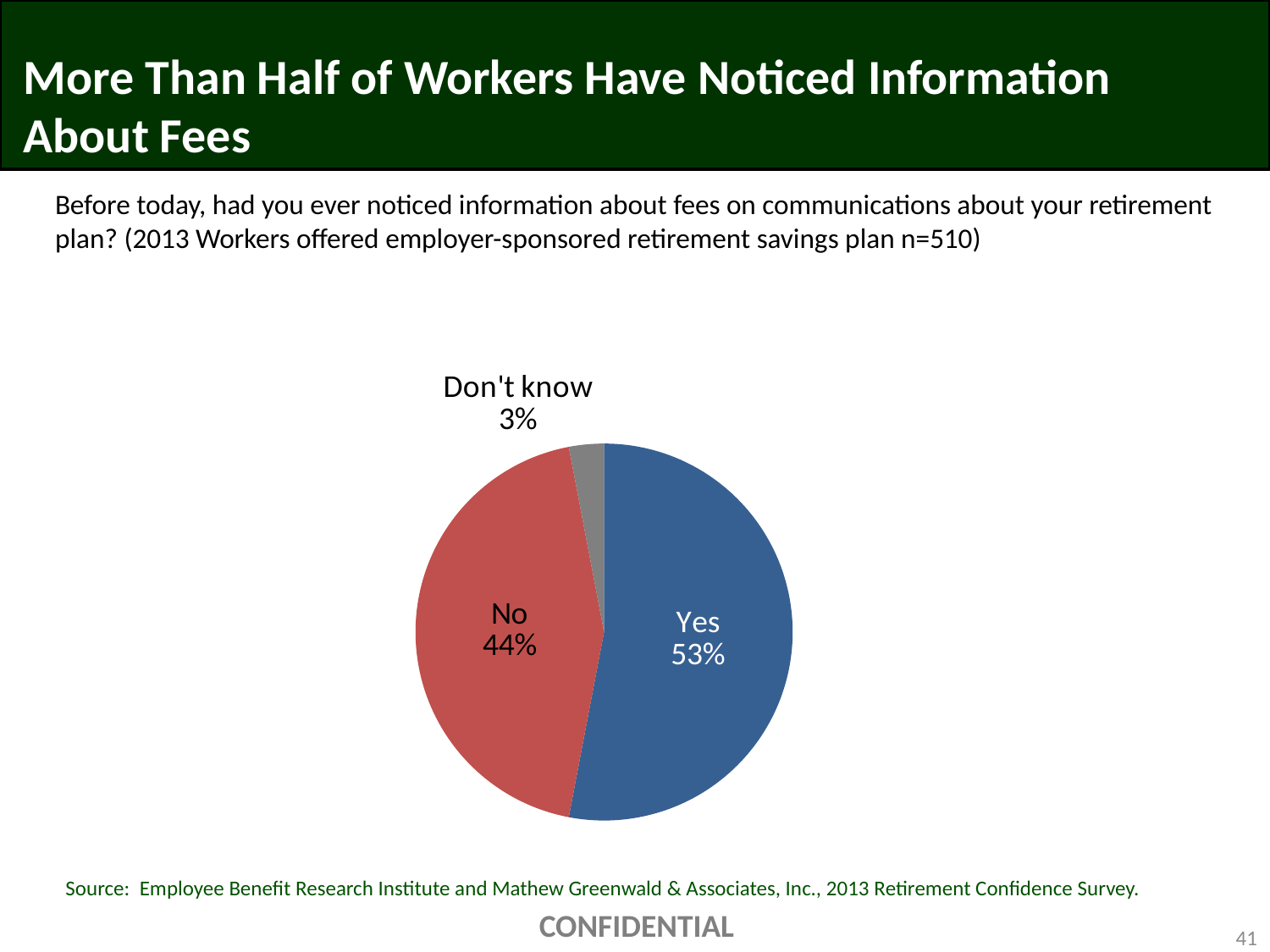
What percentage of workers answered "No"? 44% How many slices does the pie chart have? 3 Which response has the smallest share of the pie? Don't know What kind of chart is shown on the slide? pie chart Which response has the largest share of the pie? Yes Which is larger, the "No" slice or the "Don't know" slice? No What percentage of workers answered "Yes"? 53% What percentage of workers answered "Don't know"? 3% What is the sample size (n) stated in the question text above the chart? 510 What is the combined share of the "No" and "Don't know" slices? 47% What colour is the "Yes" slice? blue What is the difference in percentage points between the "Yes" and "No" slices? 9